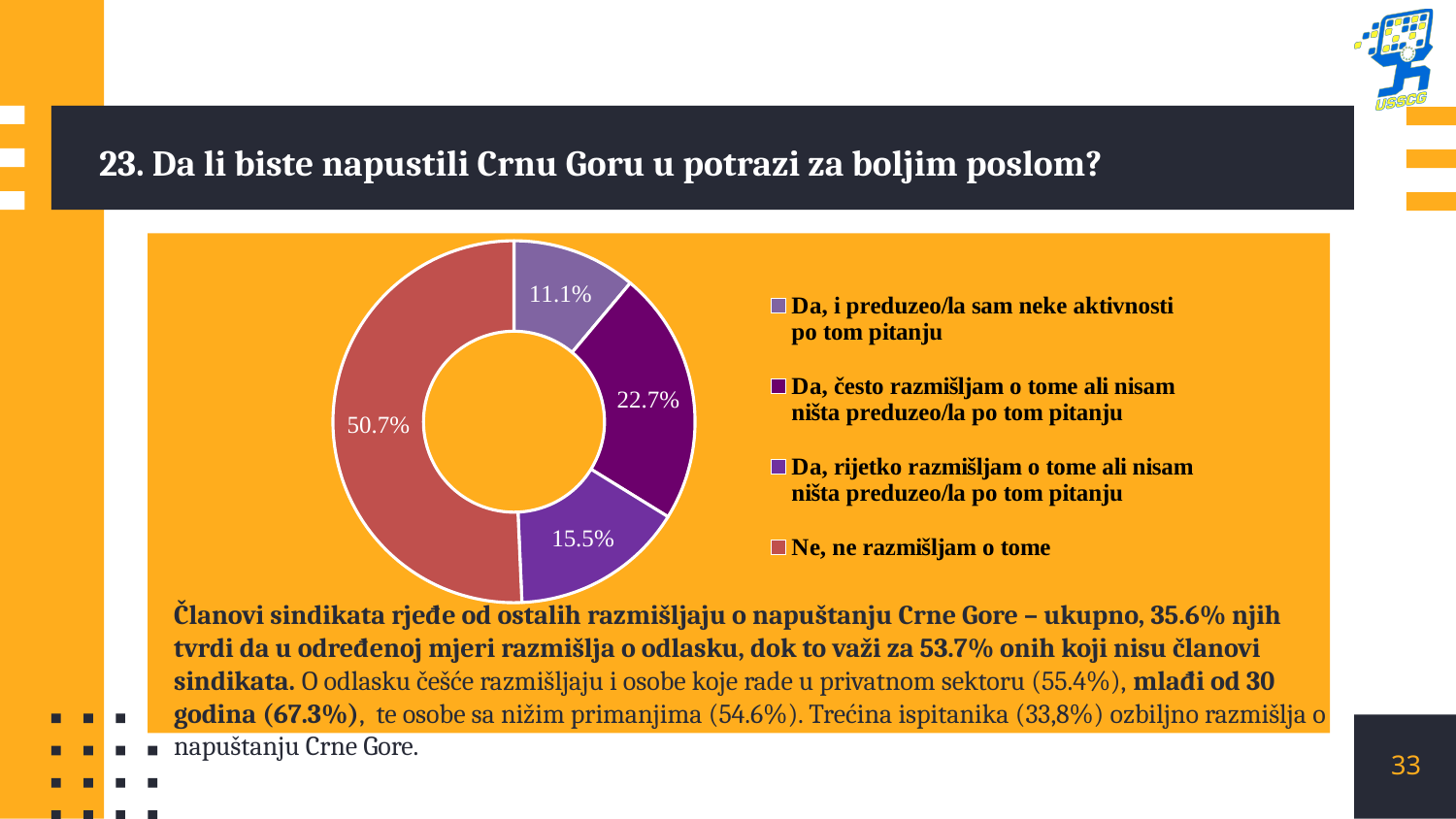
Which response category has the largest share of the chart? Ne, ne razmišljam o tome Which response category has the smallest share of the chart? Da, i preduzeo/la sam neke aktivnosti po tom pitanju What is the difference in percentage points between "Da, često razmišljam o tome ali nisam ništa preduzeo/la po tom pitanju" and "Da, rijetko razmišljam o tome ali nisam ništa preduzeo/la po tom pitanju"? 7.2 What is the combined share of the three "Da" responses? 49.3% What kind of chart is shown on the slide? Doughnut chart What percentage of respondents answered "Da, rijetko razmišljam o tome ali nisam ništa preduzeo/la po tom pitanju"? 15.5% What percentage of respondents answered "Ne, ne razmišljam o tome"? 50.7% What percentage of respondents answered "Da, i preduzeo/la sam neke aktivnosti po tom pitanju"? 11.1% What is the title of the question shown above the chart? 23. Da li biste napustili Crnu Goru u potrazi za boljim poslom? How many categories does the chart show? 4 Which is larger: the share for "Da, često razmišljam o tome ali nisam ništa preduzeo/la po tom pitanju" or for "Da, i preduzeo/la sam neke aktivnosti po tom pitanju"? Da, često razmišljam o tome ali nisam ništa preduzeo/la po tom pitanju What percentage of respondents answered "Da, često razmišljam o tome ali nisam ništa preduzeo/la po tom pitanju"? 22.7%